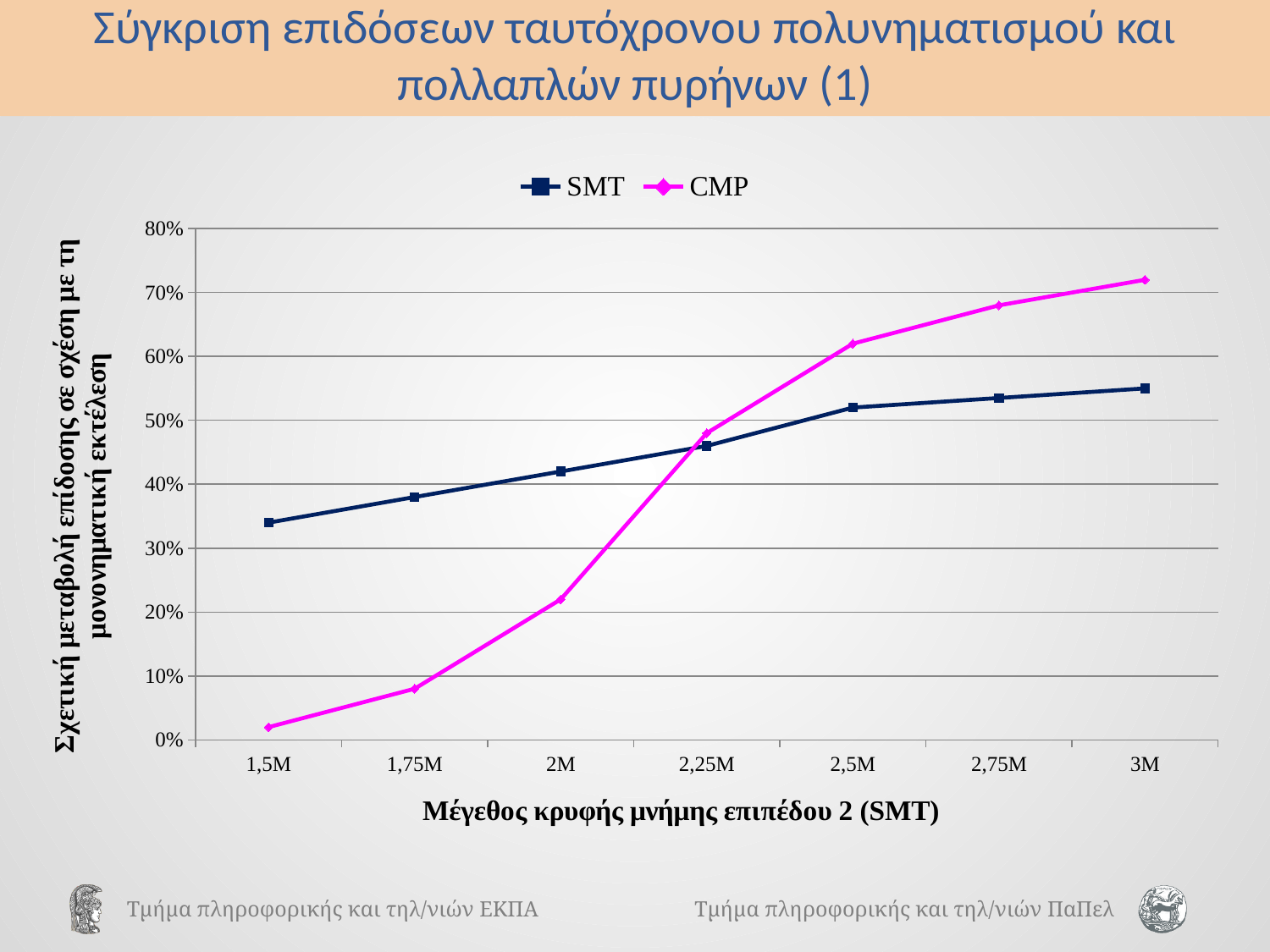
How many cache-size categories are shown on the x axis? 7 Is the value for CMP at 1,5M greater or less than 10%? less Do the values of the CMP series rise or fall as the cache size increases along the x axis? rise Is the value for CMP at 2M greater or less than 30%? less Is the value for SMT at 3M greater or less than 60%? less What kind of chart is shown on the slide? line chart At 3M, which series has the larger value, SMT or CMP? CMP At 1,5M, which series has the larger value, SMT or CMP? SMT At which cache size does the CMP series reach its highest value? 3M How many series does the legend list? 2